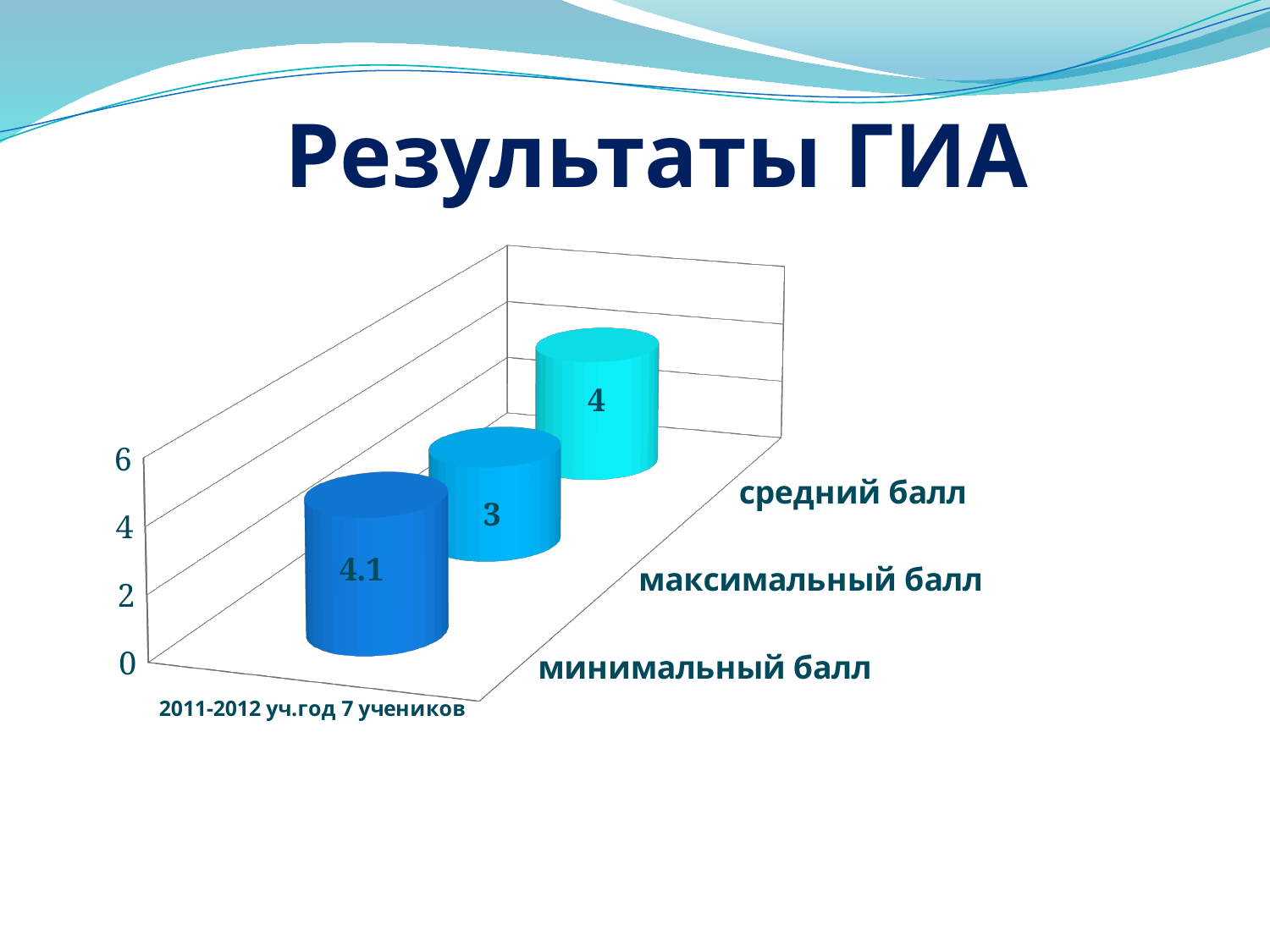
What value is printed on the middle bar of the chart? 3 What value is shown for the bar labelled 'средний балл'? 4 What is the category label shown on the horizontal axis of the chart? 2011-2012 уч.год 7 учеников Which bar has the highest value on the chart? минимальный балл (4.1) What kind of chart is shown on the slide? bar chart What value is printed on the back (lightest, cyan) bar of the chart? 4 Which bar has the lowest value on the chart? максимальный балл (3) Which is larger: the value of the back bar (средний балл) or the middle bar (максимальный балл)? средний балл (4) What value is shown for the bar labelled 'максимальный балл'? 3 What value is printed on the front (darkest blue) bar of the chart? 4.1 What is the title of the chart on the slide? Результаты ГИА What is the difference between the values of the front bar (4.1) and the middle bar (3)? 1.1